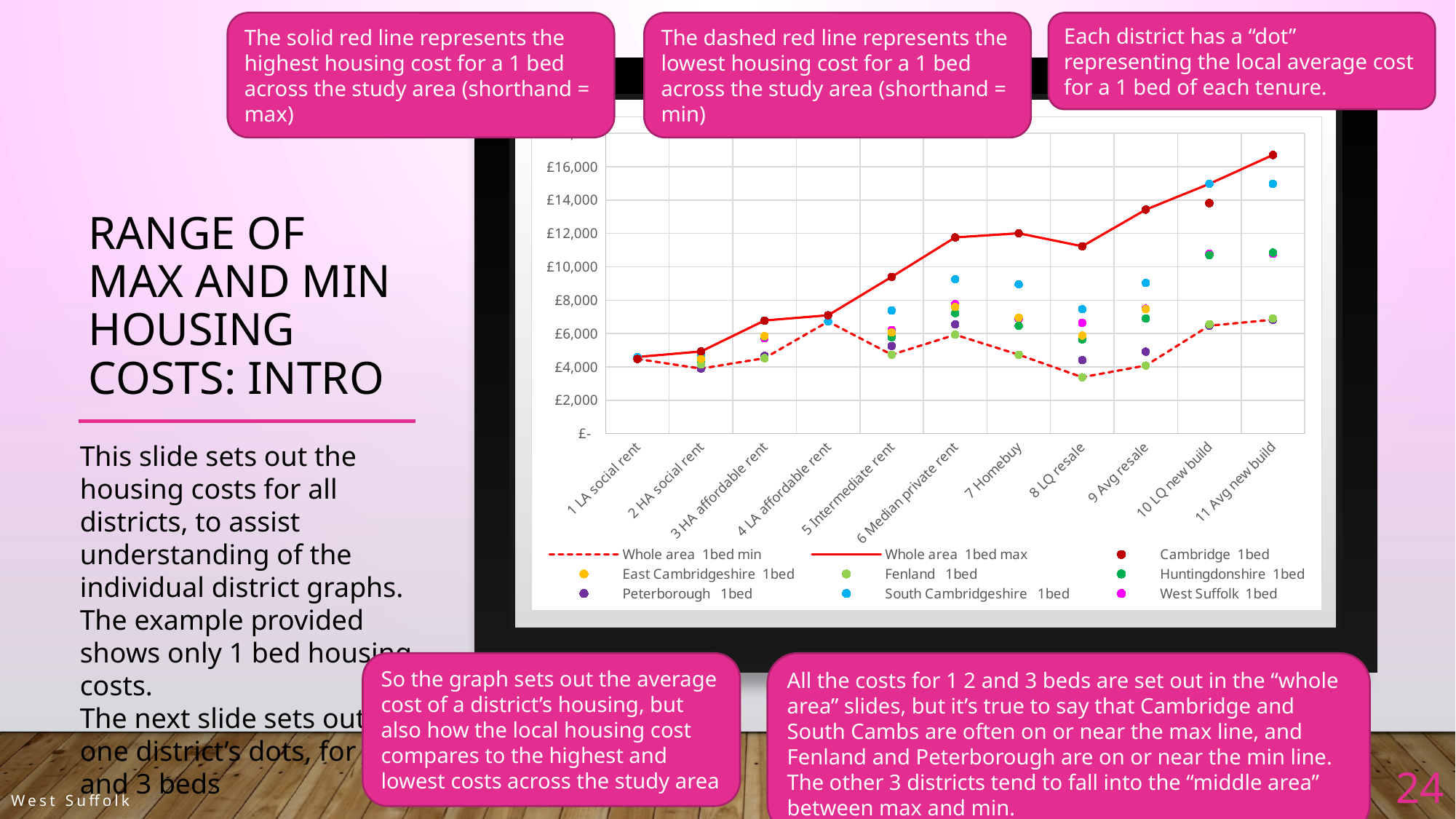
Which category has the lowest value on the dashed red 'Whole area 1bed min' line? 8 LQ resale Is the 'Whole area 1bed max' value for 9 Avg resale greater or less than £12,000? greater Which category has the highest value on the solid red 'Whole area 1bed max' line? 11 Avg new build Which series does the dashed red line in the chart represent? Whole area 1bed min On the 'Whole area 1bed max' line, which is larger: the value for 5 Intermediate rent or for 4 LA affordable rent? 5 Intermediate rent Is the Cambridge 1bed value for 10 LQ new build greater or less than £12,000? greater How many series does the chart's legend list? 9 Is the 'Whole area 1bed min' value for 8 LQ resale greater or less than £4,000? less How many categories are shown along the x axis of the chart? 11 What kind of chart is shown on the slide? line chart Does the 'Whole area 1bed max' line generally rise or fall from left to right across the x axis? rise